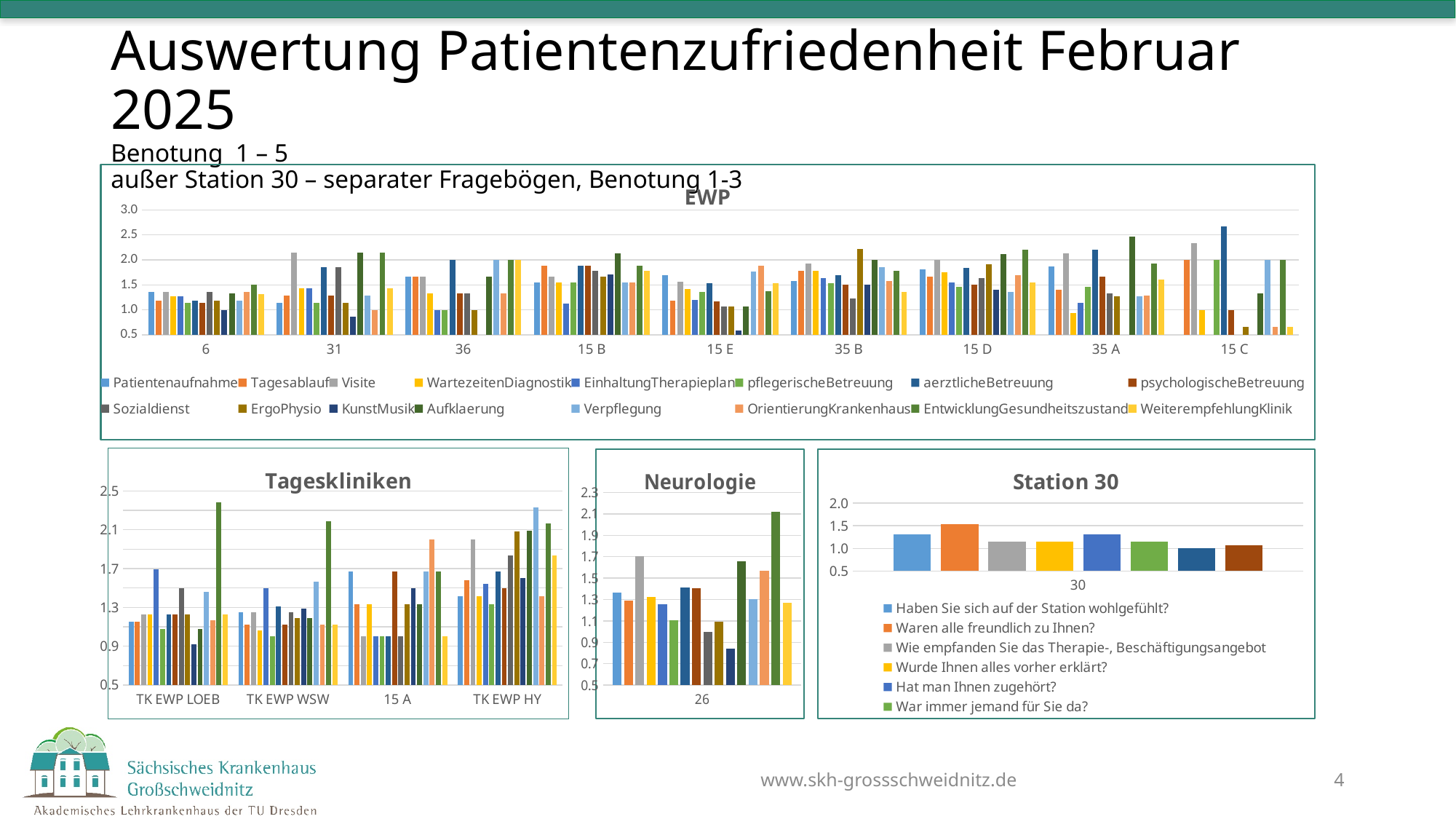
What is the highest value shown on the y axis of the Station 30 chart? 2.0 How many series does the legend of the EWP chart list? 16 In the Neurologie chart, is the tallest bar greater or less than 2.0? greater What kind of chart is the EWP chart? bar chart How many categories are shown on the x axis of the Tageskliniken chart? 4 How many categories are shown on the x axis of the EWP chart? 9 In the EWP chart, is the tallest bar for 15 C greater or less than 2.5? greater In the Station 30 chart, is the value for "Hat man Ihnen zugehört?" greater or less than 1.5? less In the Station 30 chart, which legend entry has the highest bar? Waren alle freundlich zu Ihnen? What category label appears on the x axis of the Neurologie chart? 26